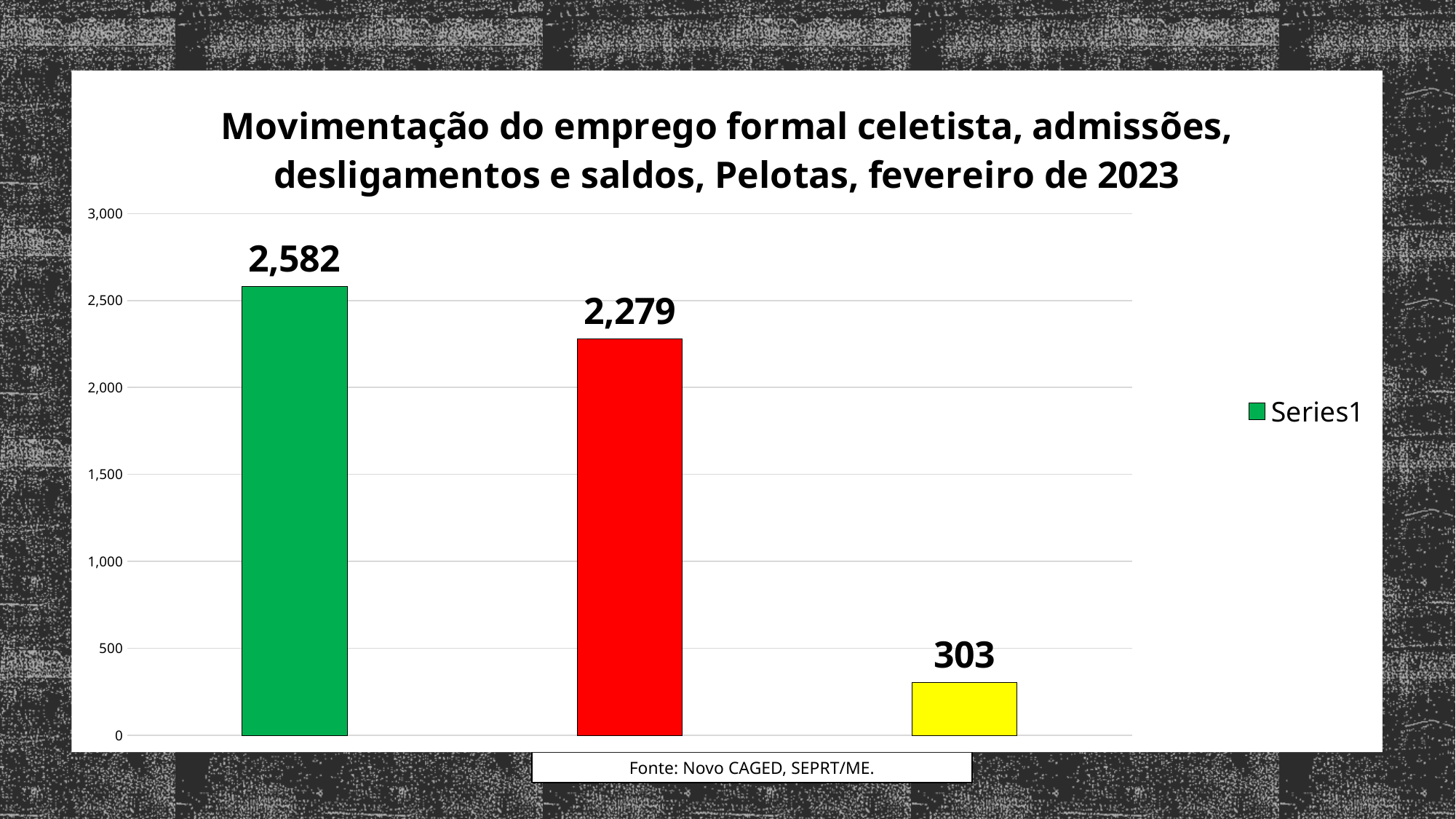
What is the difference between the green bar's value and the red bar's value? 303 Which bar has the highest value? The green bar (2,582) What is the value shown on the yellow bar (the rightmost bar)? 303 Which bar has the lowest value? The yellow bar (303) What kind of chart is shown on the slide? Bar chart What is the difference between the red bar's value and the yellow bar's value? 1,976 Which is larger, the value of the red bar or the value of the yellow bar? The red bar What is the value shown on the red bar (the middle bar)? 2,279 How many series does the legend list? 1 What is the value shown on the green bar (the first bar from the left)? 2,582 How many bars are plotted in the chart? 3 Is the value of the red bar greater or less than 2,500? less